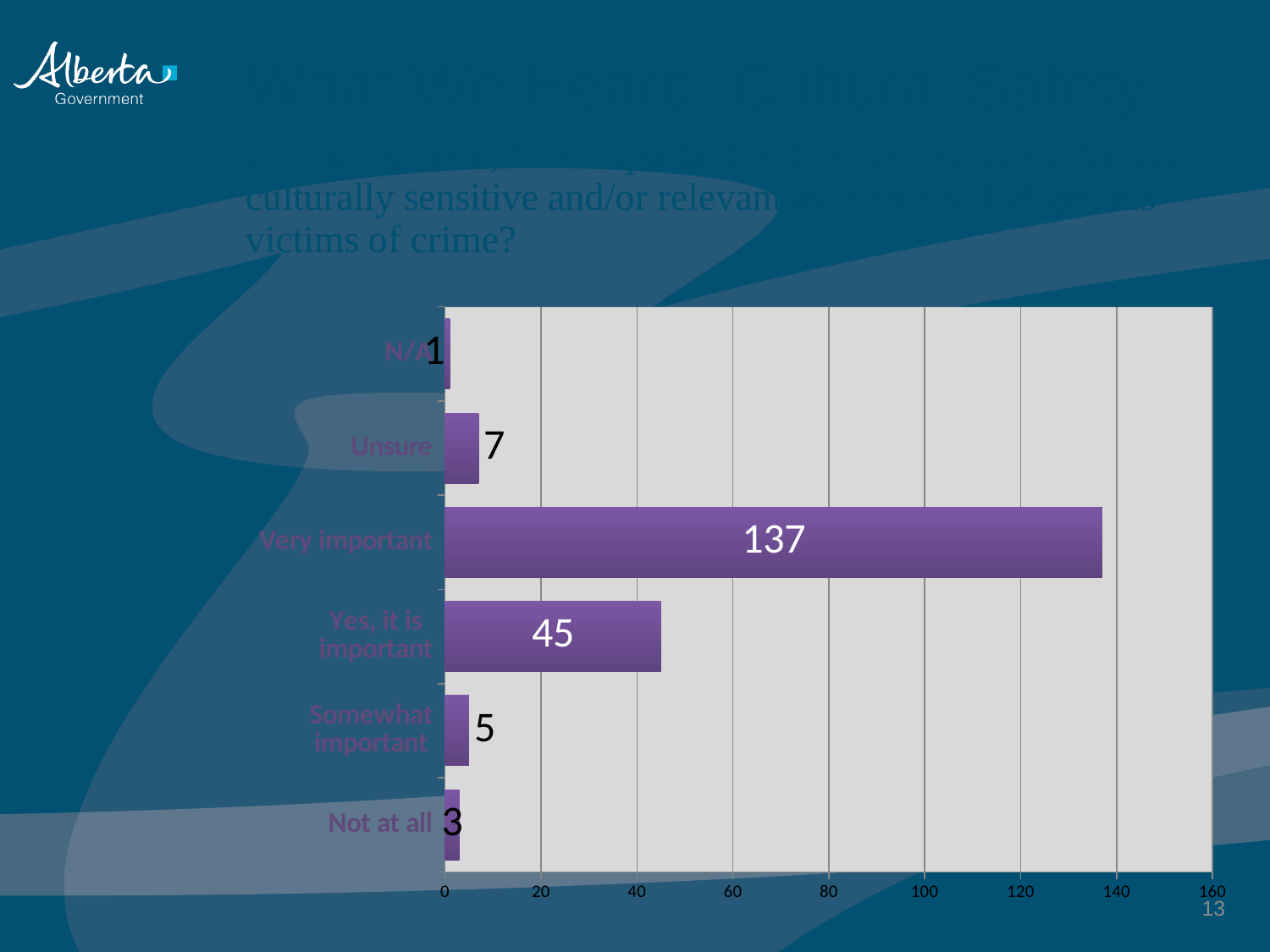
Which is larger, the value for "Unsure" or the value for "Somewhat important"? Unsure Which category has the highest value? Very important What is the value for "Unsure"? 7 How many categories are shown in the chart? 6 Is the value for "Very important" greater or less than 120? greater What is the difference between the values for "Very important" and "Yes, it is important"? 92 What is the maximum value shown on the horizontal axis? 160 What is the value for "Not at all"? 3 What kind of chart is shown on the slide? bar chart What is the value for "Yes, it is important"? 45 Which category has the lowest value? N/A What is the value for "Very important"? 137